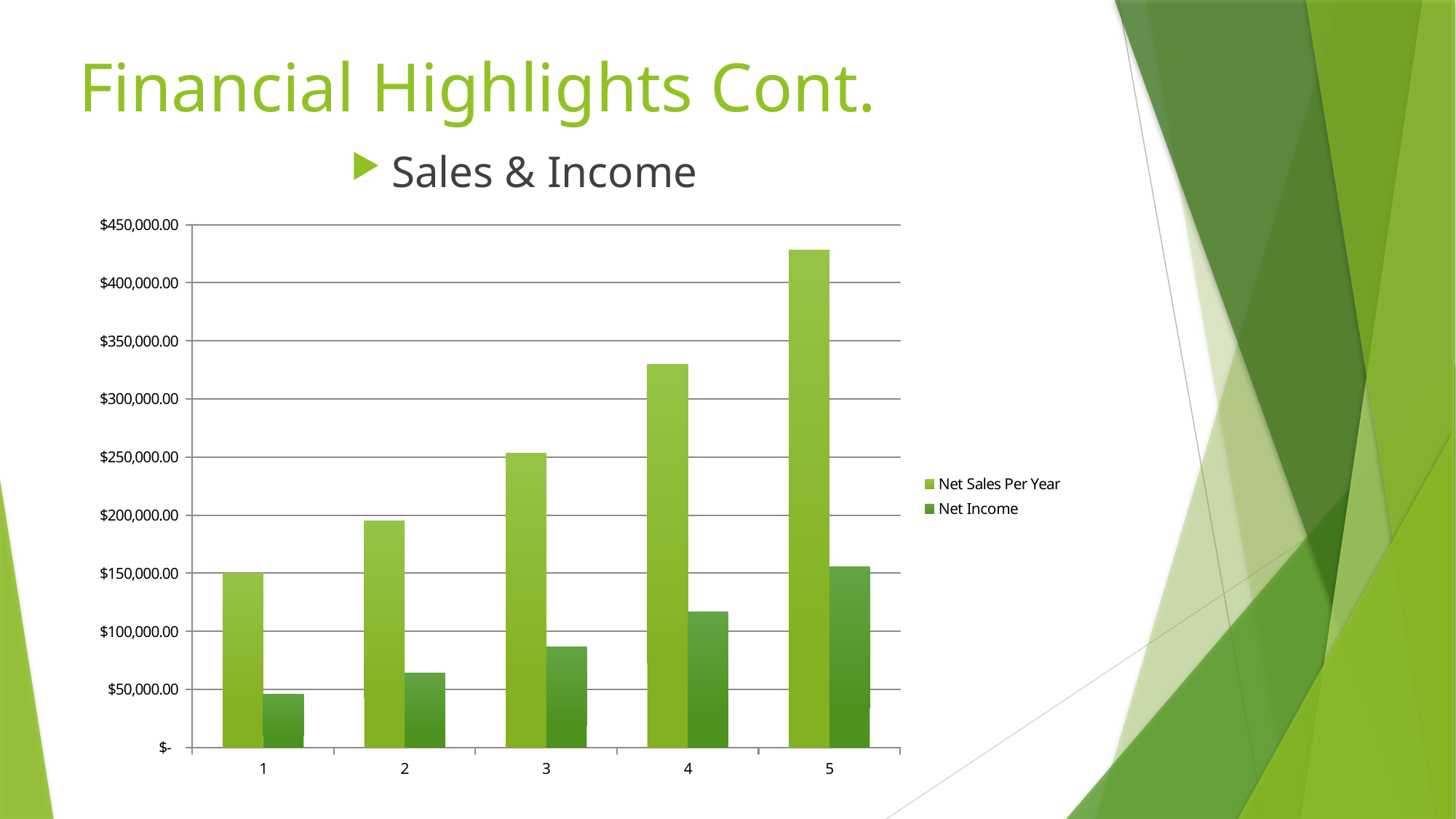
Which category has the highest Net Sales Per Year? 5 Is the Net Income value for category 3 greater or less than $100,000.00? less Is the Net Sales Per Year value for category 5 greater or less than $400,000.00? greater How many categories are shown on the x axis? 5 What are the two series named in the legend? Net Sales Per Year and Net Income Is the Net Sales Per Year value for category 4 greater or less than $300,000.00? greater Which category has the lowest Net Income? 1 What kind of chart is shown on the slide? bar chart Which is larger: Net Income for category 5 or Net Sales Per Year for category 1? Net Income for category 5 Do the Net Sales Per Year values rise or fall from category 1 to category 5? rise Which is larger for category 2: Net Sales Per Year or Net Income? Net Sales Per Year How many series does the legend list? 2